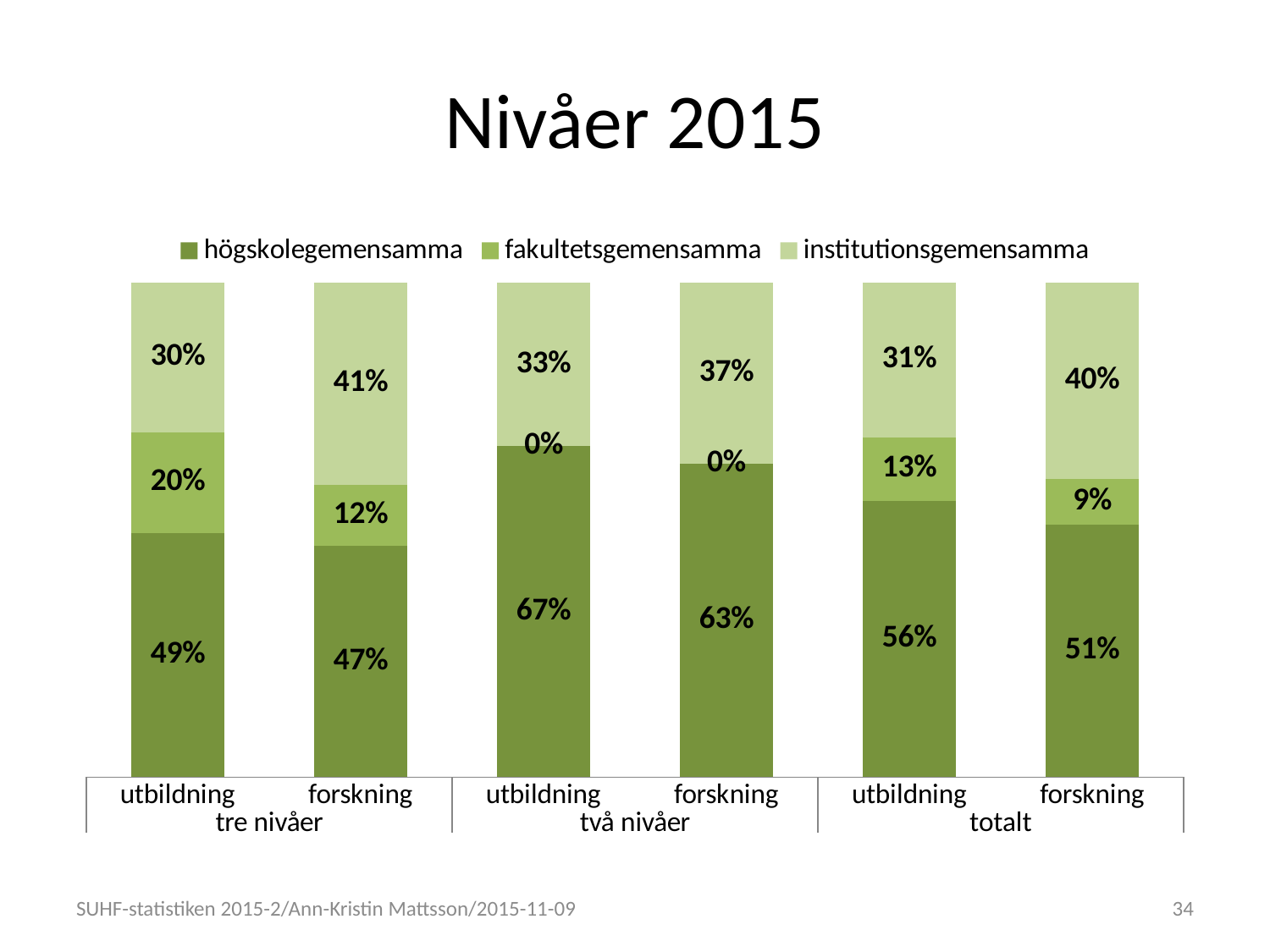
What is the institutionsgemensamma share for forskning under tre nivåer? 41% What is the högskolegemensamma share for utbildning under tre nivåer? 49% What is the title of the chart? Nivåer 2015 What is the högskolegemensamma share for forskning under totalt? 51% Which bar has the highest högskolegemensamma share? utbildning, två nivåer How many bars are plotted in the chart? 6 What is the fakultetsgemensamma share for utbildning under två nivåer? 0% How many series does the legend list? 3 Which bar has the lowest institutionsgemensamma share? utbildning, tre nivåer What is the difference between the högskolegemensamma shares for utbildning and forskning under totalt? 5% What type of chart is shown on the slide? stacked bar chart Which is larger: the fakultetsgemensamma share for utbildning under tre nivåer or for utbildning under totalt? utbildning under tre nivåer